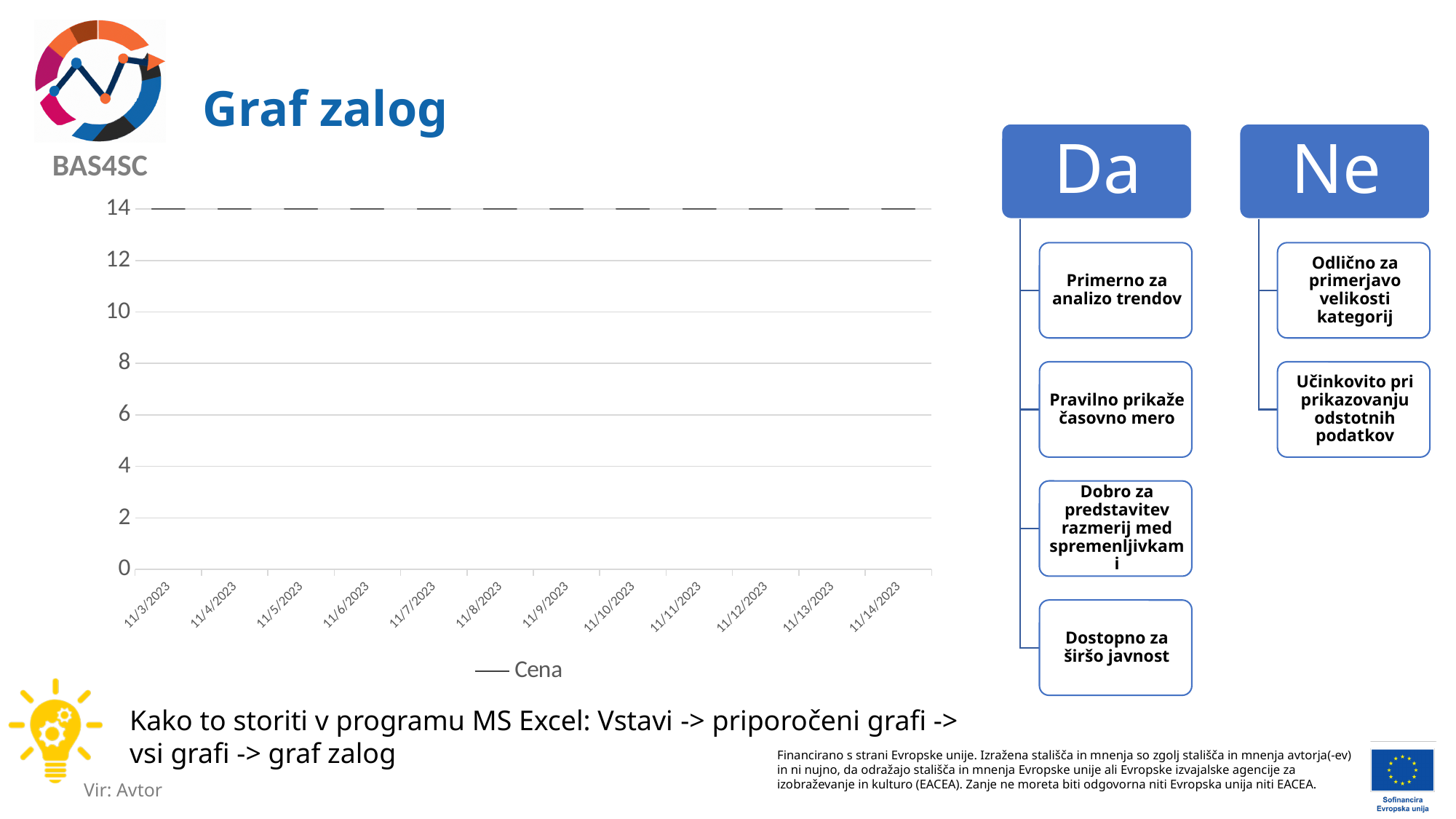
How many series does the chart legend list? 1 What is the title of the chart on the slide? Graf zalog What is the name of the series shown in the chart legend? Cena How many dates are shown on the x axis of the chart? 12 What is the highest value shown on the y axis of the chart? 14 Is the value of Cena on 11/10/2023 greater or less than 10? greater What is the first date shown on the x axis of the chart? 11/3/2023 What is the last date shown on the x axis of the chart? 11/14/2023